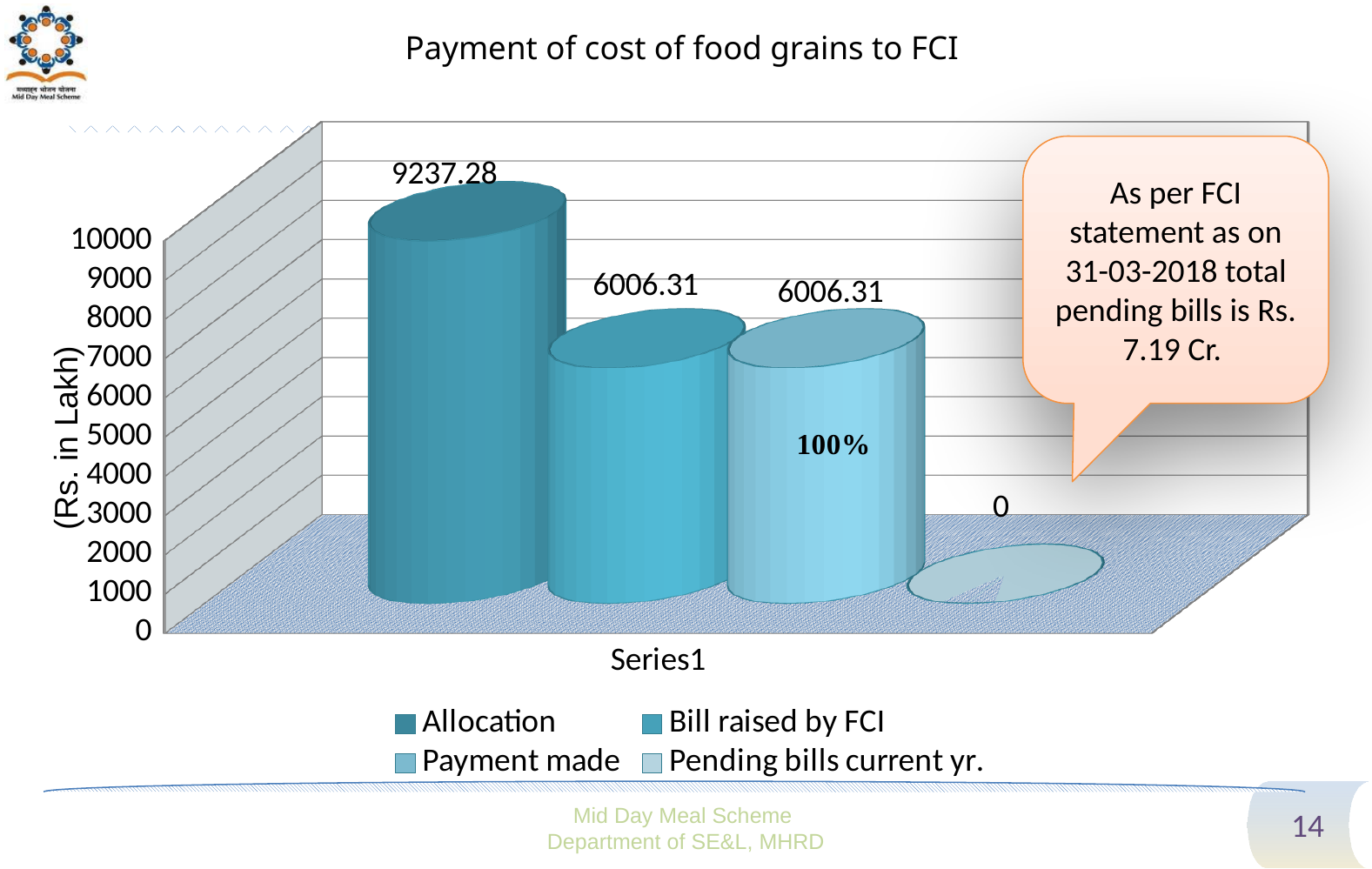
Which series has the highest value? Allocation Which is larger, Allocation or Payment made? Allocation What is the value for Payment made? 6006.31 How many series does the legend list? 4 What kind of chart is shown on the slide? Bar chart What is the value for Pending bills current yr.? 0 What is the value for Bill raised by FCI? 6006.31 What is the difference between Allocation and Bill raised by FCI? 3230.97 Which series has the lowest value? Pending bills current yr. What is the title of the chart? Payment of cost of food grains to FCI Is the value for Allocation greater or less than 9000? greater What is the value for Allocation? 9237.28